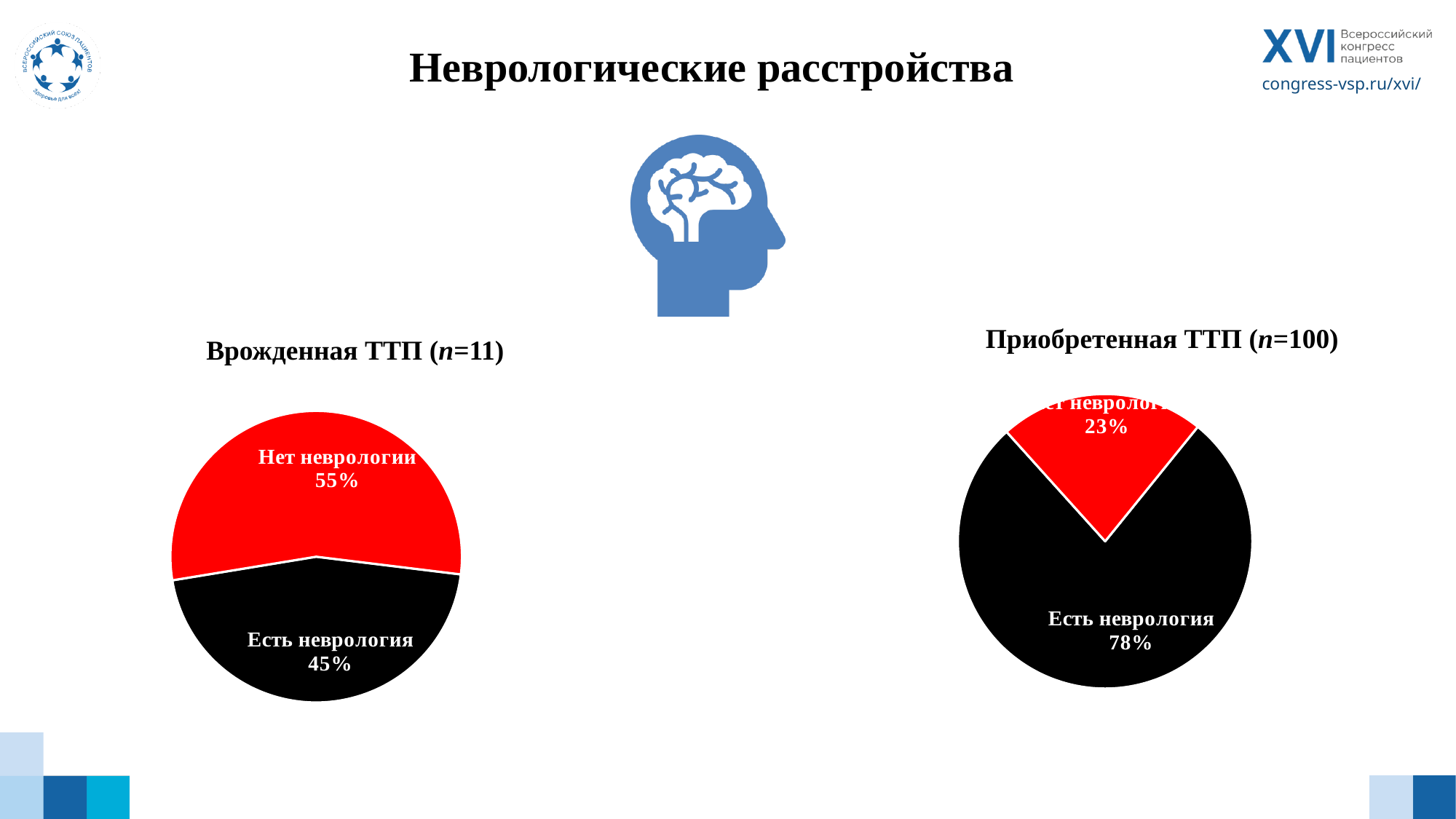
Which chart shows a larger share for "Есть неврология": "Врожденная ТТП (n=11)" or "Приобретенная ТТП (n=100)"? Приобретенная ТТП (n=100) In the chart titled "Врожденная ТТП (n=11)", which slice is the largest? Нет неврологии What type of chart is used for "Приобретенная ТТП (n=100)"? Pie chart In the chart titled "Врожденная ТТП (n=11)", what is the difference in percentage points between "Нет неврологии" and "Есть неврология"? 10 How many slices does the chart titled "Врожденная ТТП (n=11)" have? 2 In the chart titled "Врожденная ТТП (n=11)", what share is labelled "Есть неврология"? 45% In the chart titled "Приобретенная ТТП (n=100)", what percentage is shown for the red slice? 23% In the chart titled "Приобретенная ТТП (n=100)", which slice is the smallest? Нет неврологии In the chart titled "Приобретенная ТТП (n=100)", what share is labelled "Есть неврология"? 78% In the chart titled "Врожденная ТТП (n=11)", what share is labelled "Нет неврологии"? 55% In the chart titled "Врожденная ТТП (n=11)", what colour is the "Есть неврология" slice? Black In the chart titled "Приобретенная ТТП (n=100)", what is the difference in percentage points between "Есть неврология" and the red slice? 55